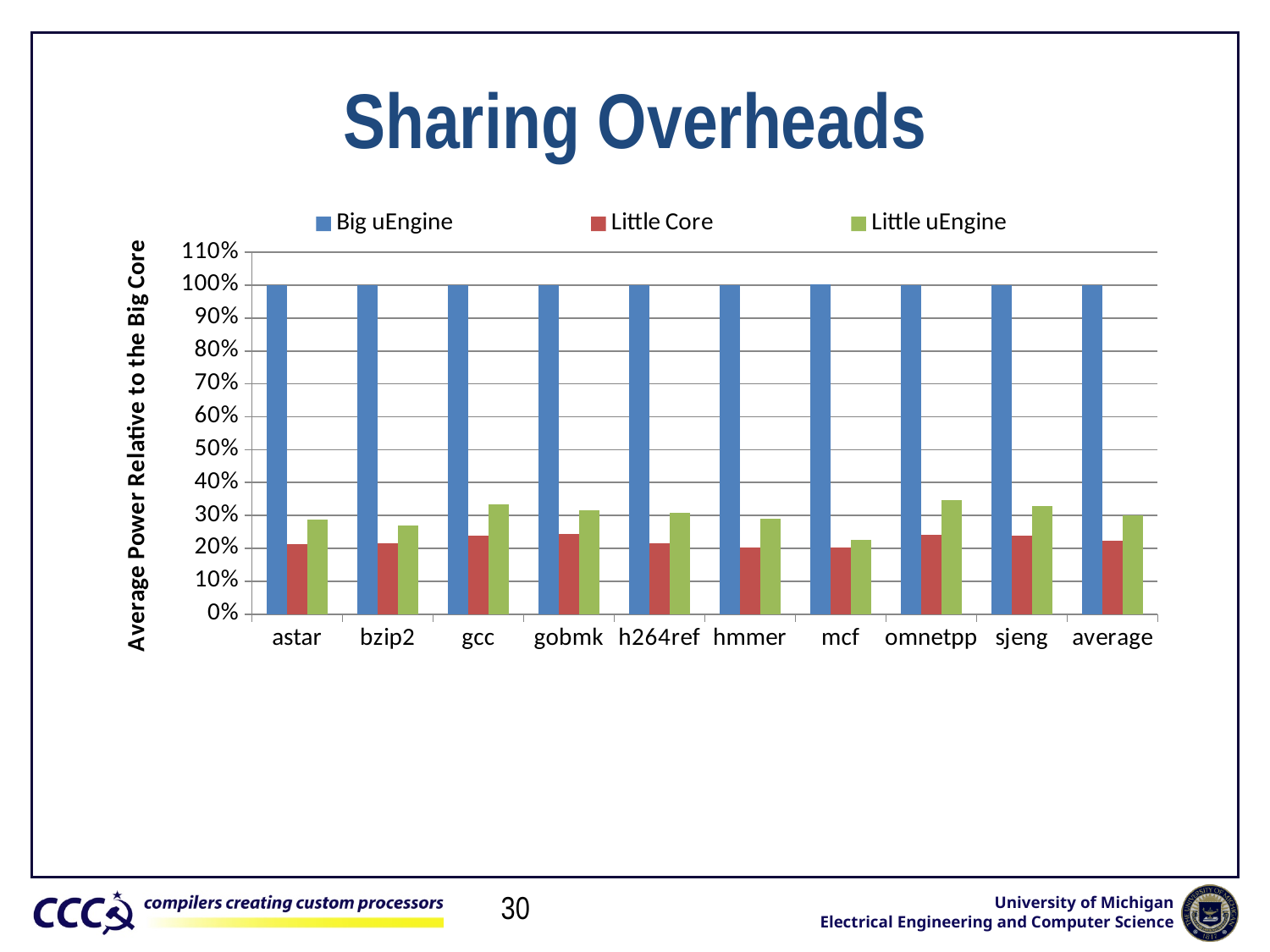
Is the value of Little uEngine for mcf greater or less than 30%? less What is the title of the y axis? Average Power Relative to the Big Core How many series does the legend list? 3 Is the value of Little Core for mcf greater or less than 30%? less How many categories are shown on the x axis? 10 What is the value of Big uEngine for astar? 100% Which category has the lowest Little uEngine value? mcf Is the value of Little uEngine for omnetpp greater or less than 30%? greater For astar, which is larger: Little Core or Little uEngine? Little uEngine What is the value of Big uEngine for average? 100% What kind of chart is shown on the slide? bar chart For Little uEngine, which is larger: omnetpp or mcf? omnetpp